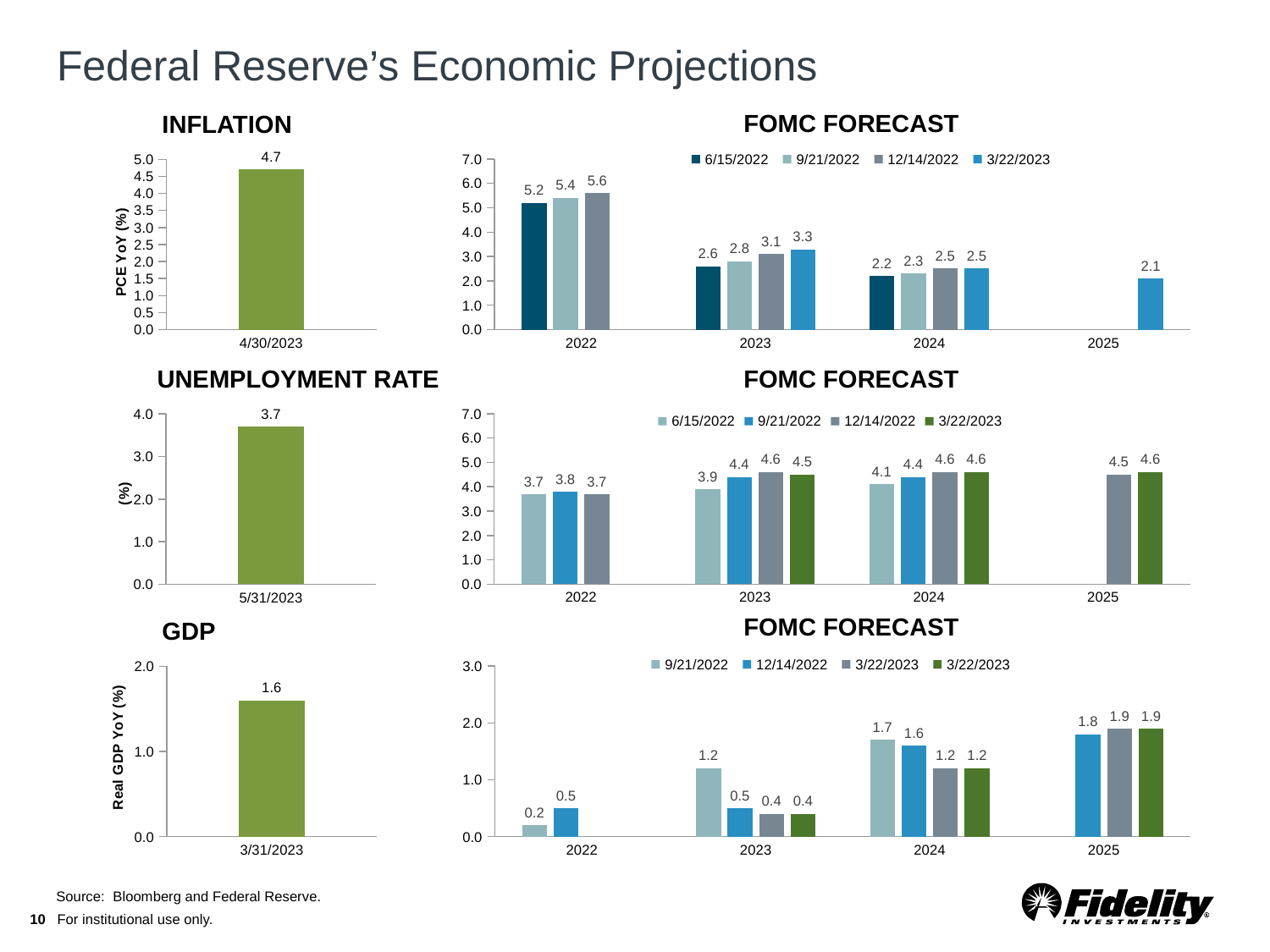
In the UNEMPLOYMENT RATE chart on the left, what is the value shown for 5/31/2023? 3.7 What type of chart is the GDP chart on the left? Bar chart How many series does the legend list in the middle-right FOMC FORECAST chart (unemployment)? 4 In the middle-right FOMC FORECAST chart (unemployment), what is the 3/22/2023 forecast for 2025? 4.6 In the bottom-right FOMC FORECAST chart (GDP), which is larger: the 9/21/2022 forecast for 2024 or the 12/14/2022 forecast for 2024? 9/21/2022 In the top-right FOMC FORECAST chart (inflation), which year has the highest forecast values? 2022 In the INFLATION chart on the left, what is the value shown for 4/30/2023? 4.7 How many year categories are shown on the x axis of the bottom-right FOMC FORECAST chart (GDP)? 4 In the GDP chart on the left, what is the value shown for 3/31/2023? 1.6 In the top-right FOMC FORECAST chart (inflation), what is the difference between the 12/14/2022 and 6/15/2022 forecasts for 2022? 0.4 In the top-right FOMC FORECAST chart (inflation), what is the 3/22/2023 forecast for 2023? 3.3 In the bottom-right FOMC FORECAST chart (GDP), what is the 9/21/2022 forecast for 2022? 0.2